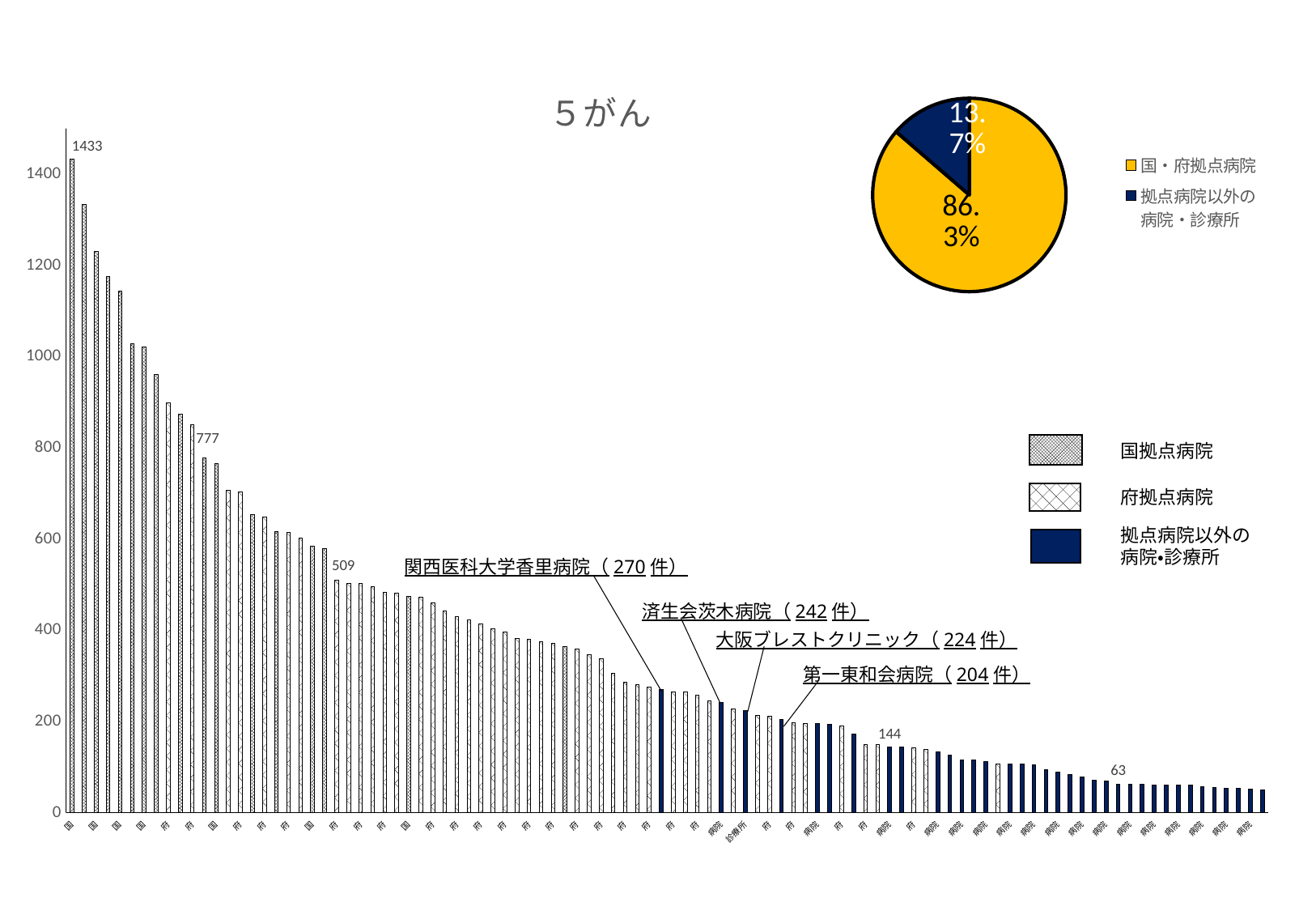
In the bar chart titled ５がん, how many cases are annotated for 関西医科大学香里病院? 270 件 In the bar chart titled ５がん, how many cases are annotated for 済生会茨木病院? 242 件 In the bar chart titled ５がん, what is the difference between the cases for 関西医科大学香里病院 and 済生会茨木病院? 28 What kind of chart is the large chart titled ５がん? bar chart In the pie chart, what share is labelled for 拠点病院以外の病院・診療所? 13.7% In the pie chart, what share is labelled for 国・府拠点病院? 86.3% In the bar chart titled ５がん, how many cases are annotated for 大阪ブレストクリニック? 224 件 In the bar chart titled ５がん, how many cases are annotated for 第一東和会病院? 204 件 In the bar chart titled ５がん, do the values rise or fall from left to right? fall How many series does the legend of the bar chart titled ５がん list? 3 In the bar chart titled ５がん, which has more cases, 大阪ブレストクリニック or 第一東和会病院? 大阪ブレストクリニック In the bar chart titled ５がん, what is the value of the tallest bar? 1433